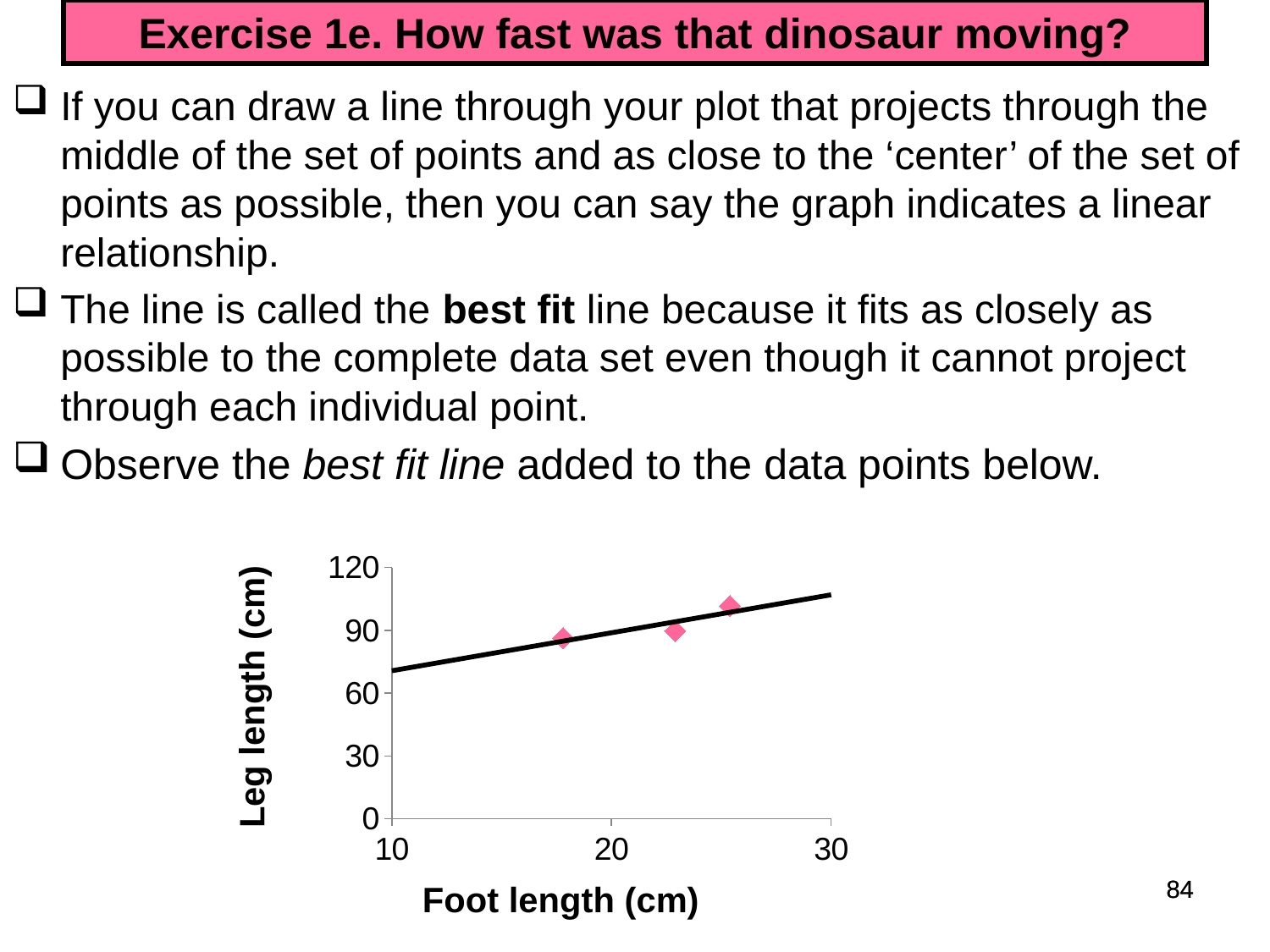
Is the leg length of the data point with the largest foot length greater or less than 90? greater What is the label on the x axis of the chart? Foot length (cm) Is the foot length of the leftmost data point greater or less than 20? less What is the label on the y axis of the chart? Leg length (cm) Do the leg length values rise or fall as foot length increases along the x axis? Rise How many data points are plotted on the chart? 3 What kind of chart is shown on the slide? Scatter plot Is the foot length of the rightmost data point greater or less than 20? greater Which data point has the highest leg length: the one with the smallest foot length or the one with the largest foot length? The one with the largest foot length